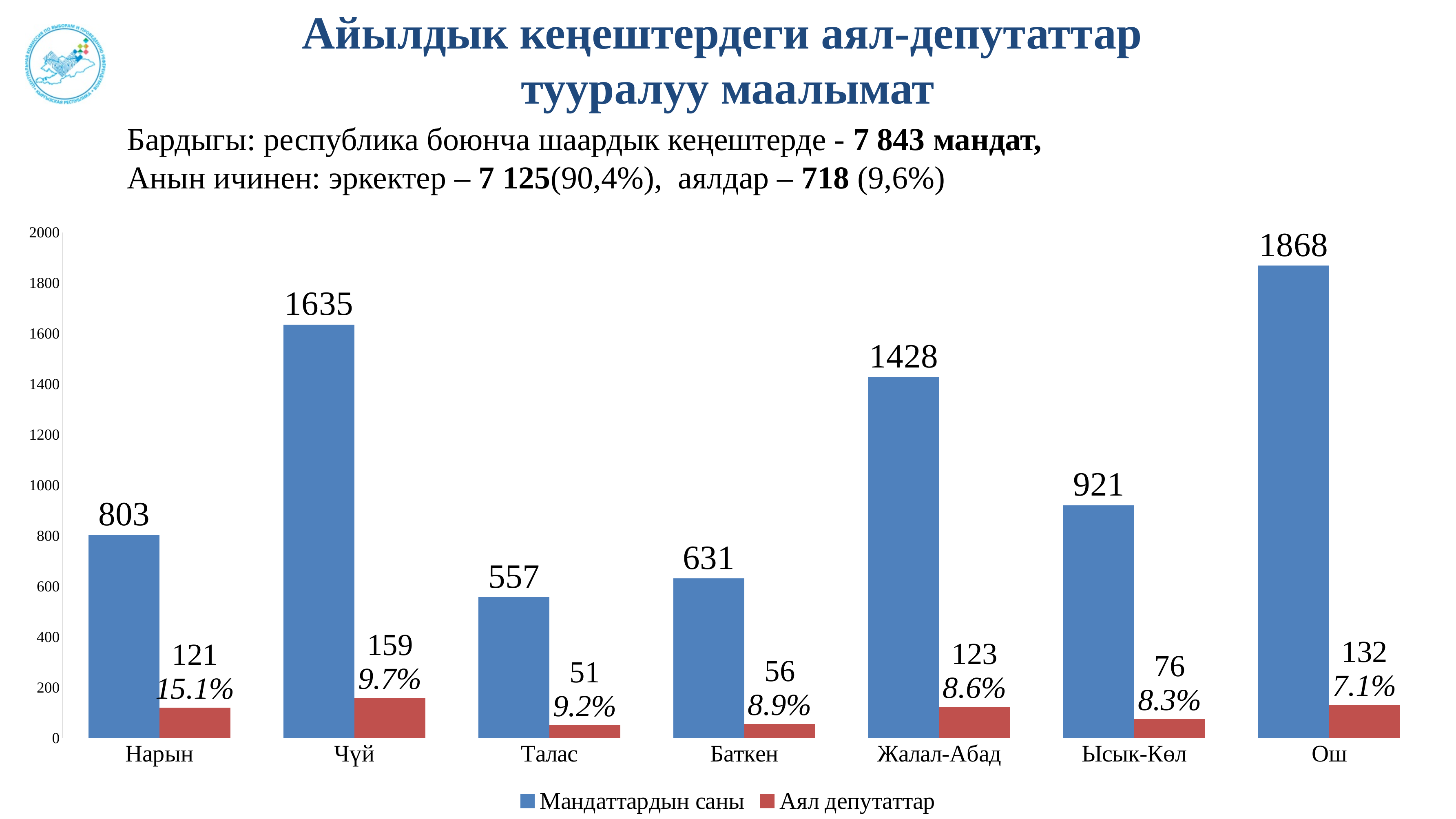
Which category has the lowest value for Аял депутаттар? Талас How many categories are shown on the x axis? 7 What kind of chart is shown on the slide? bar chart How many series does the legend list? 2 Which category has the highest value for Мандаттардын саны? Ош What percentage is shown above the Аял депутаттар bar for Нарын? 15.1% Is the value of Мандаттардын саны for Баткен greater or less than 800? less What is the difference between the Мандаттардын саны values for Ош and Чүй? 233 Which is larger, the Мандаттардын саны value for Нарын or for Ысык-Көл? Ысык-Көл What colour are the Аял депутаттар bars? red What is the value of Мандаттардын саны for Чүй? 1635 What is the value of Аял депутаттар for Жалал-Абад? 123